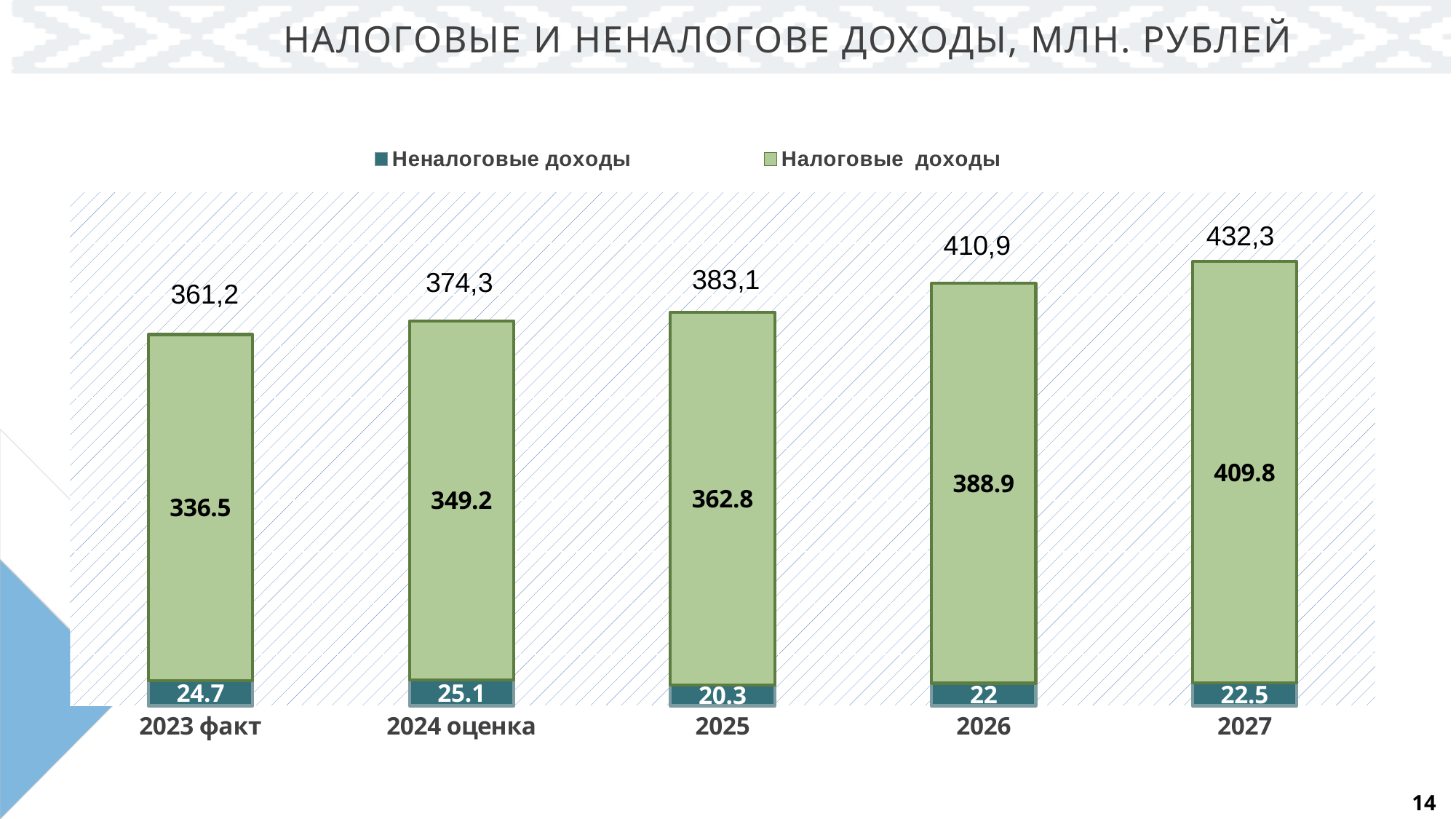
What is the difference between Налоговые доходы in 2027 and in 2023 факт? 73.3 Which is larger: Неналоговые доходы in 2023 факт or in 2026? 2023 факт How many categories are shown on the x axis? 5 What is the total shown above the bar for 2027? 432,3 What type of chart is shown on the slide? Stacked bar chart What is the title of the chart? НАЛОГОВЫЕ И НЕНАЛОГОВЕ ДОХОДЫ, МЛН. РУБЛЕЙ What is the value of Неналоговые доходы for 2024 оценка? 25.1 Do the total values rise or fall from 2023 факт to 2027? Rise Which category has the lowest value of Неналоговые доходы? 2025 How many series does the legend list? 2 Which category has the highest value of Налоговые доходы? 2027 What is the value of Налоговые доходы for 2025? 362.8